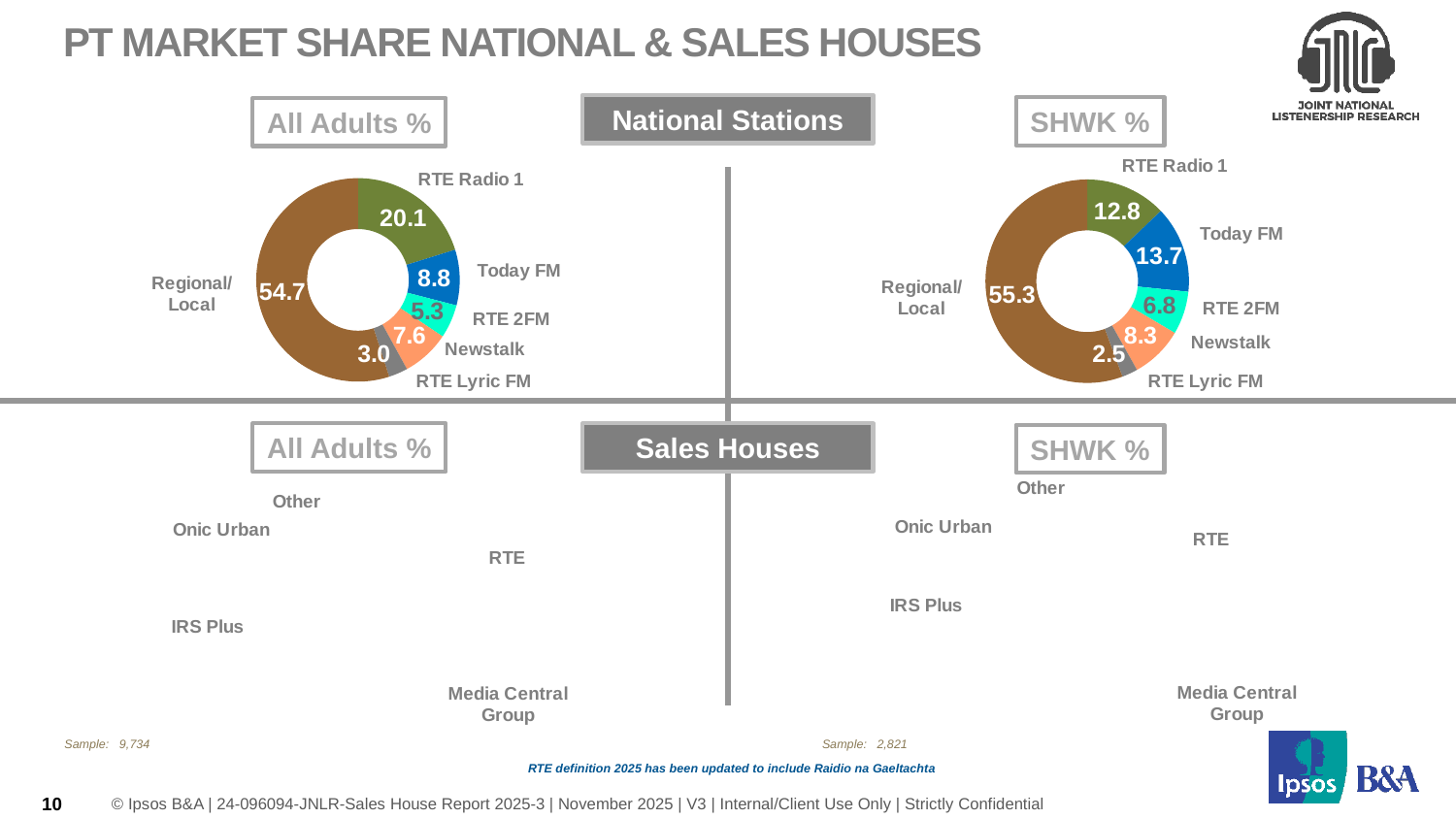
What type of chart is used for the National Stations All Adults % data? Donut (pie) chart In the National Stations All Adults % chart, what is the value for RTE Radio 1? 20.1 In the National Stations All Adults % chart, what is the difference between RTE Radio 1 and Today FM? 11.3 How many categories are shown in the National Stations All Adults % chart? 6 In the National Stations All Adults % chart, which category has the highest value? Regional/Local What is the sample size shown for the SHWK % charts? 2,821 In the National Stations SHWK % chart, which category has the lowest value? RTE Lyric FM In the National Stations All Adults % chart, what is the value for Regional/Local? 54.7 In the National Stations SHWK % chart, which is larger, Newstalk or RTE 2FM? Newstalk In the National Stations SHWK % chart, what is the value for Today FM? 13.7 In the National Stations SHWK % chart, what is the difference between Regional/Local and RTE Radio 1? 42.5 In the National Stations All Adults % chart, what is the value for RTE Lyric FM? 3.0